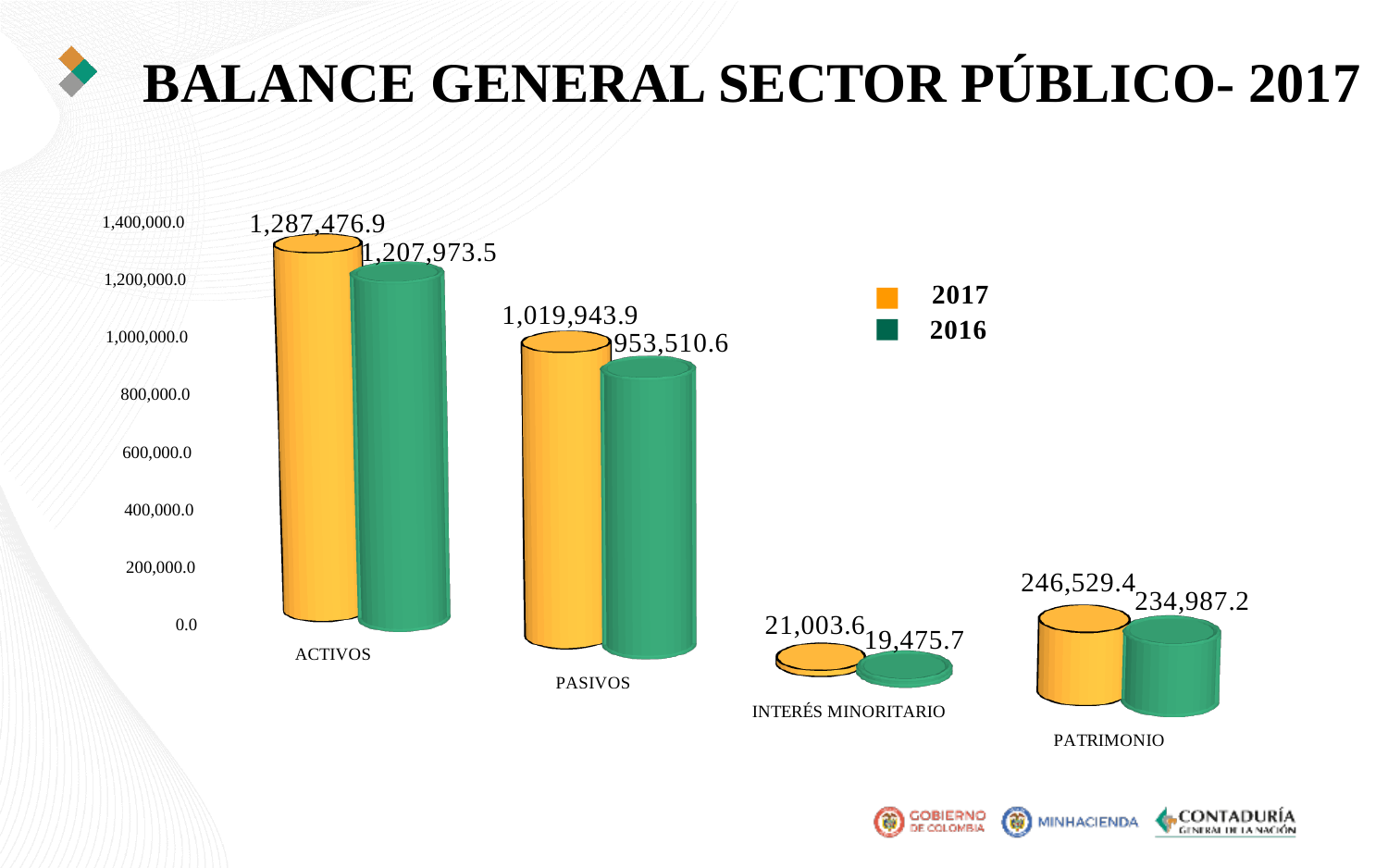
Which is larger, the 2017 value for PASIVOS or the 2016 value for ACTIVOS? 2016 value for ACTIVOS What is the 2017 value for ACTIVOS? 1,287,476.9 What is the 2016 value for PATRIMONIO? 234,987.2 How many categories are shown on the x axis? 4 Which category has the lowest 2016 value? INTERÉS MINORITARIO What is the 2016 value for PASIVOS? 953,510.6 How many series does the legend list? 2 What is the difference between the 2017 and 2016 values for PATRIMONIO? 11,542.2 What is the difference between the 2017 and 2016 values for ACTIVOS? 79,503.4 Which category has the highest 2017 value? ACTIVOS What kind of chart is shown on the slide? Bar chart What is the 2017 value for INTERÉS MINORITARIO? 21,003.6